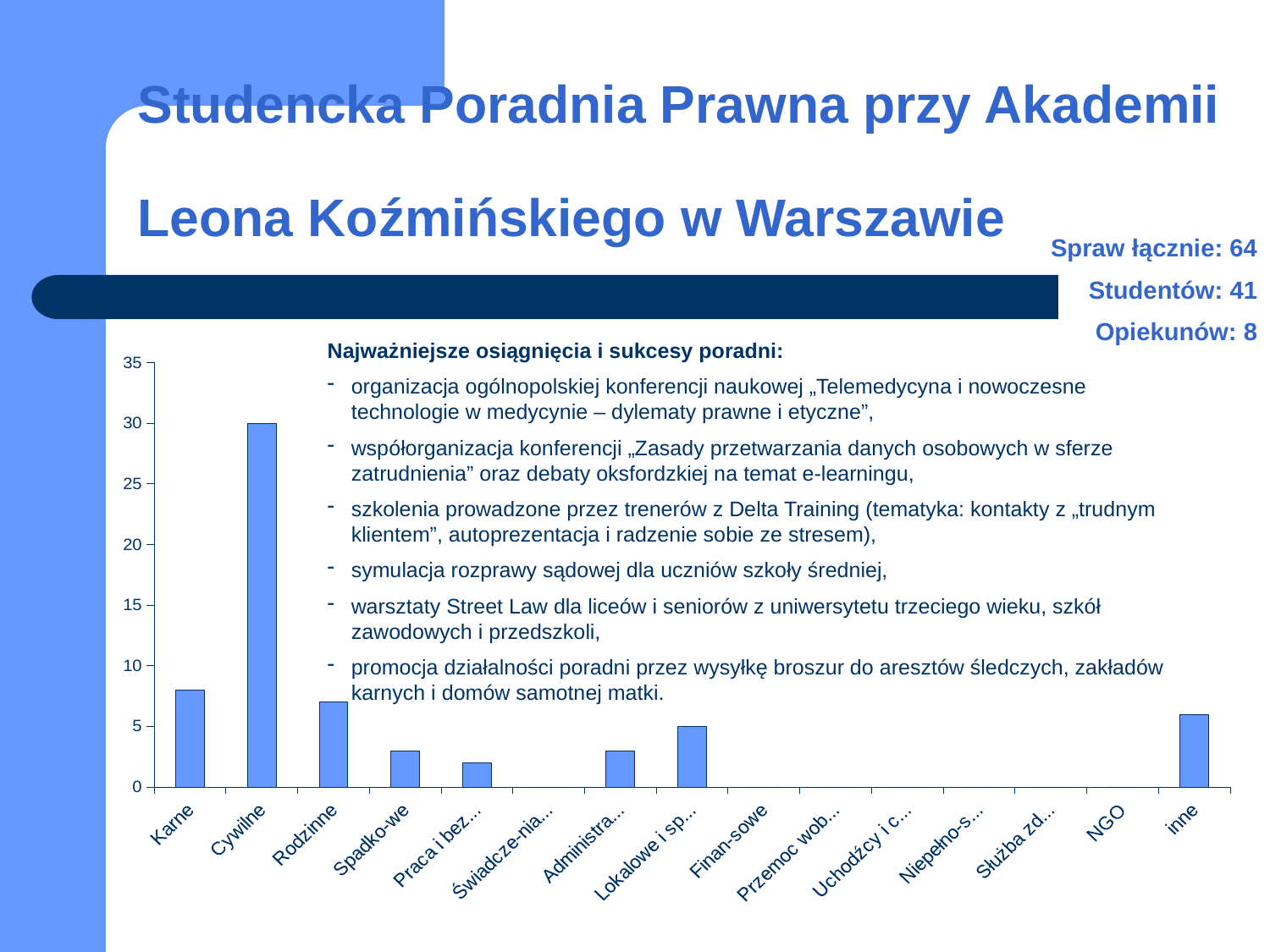
Is the value for Rodzinne greater or less than 5? greater Which is larger, the value for Karne or the value for Spadko-we? Karne Is the value for Karne greater or less than 5? greater Which category has the highest bar in the chart? Cywilne What is the value for Lokalowe i sp... in the chart? 5 Is the value for inne greater or less than 10? less What is the value for Cywilne in the chart? 30 What kind of chart is shown on the slide? bar chart Which is larger, the value for Cywilne or the value for Rodzinne? Cywilne What is the difference between the values for Cywilne and Lokalowe i sp...? 25 How many categories are shown on the x axis of the chart? 15